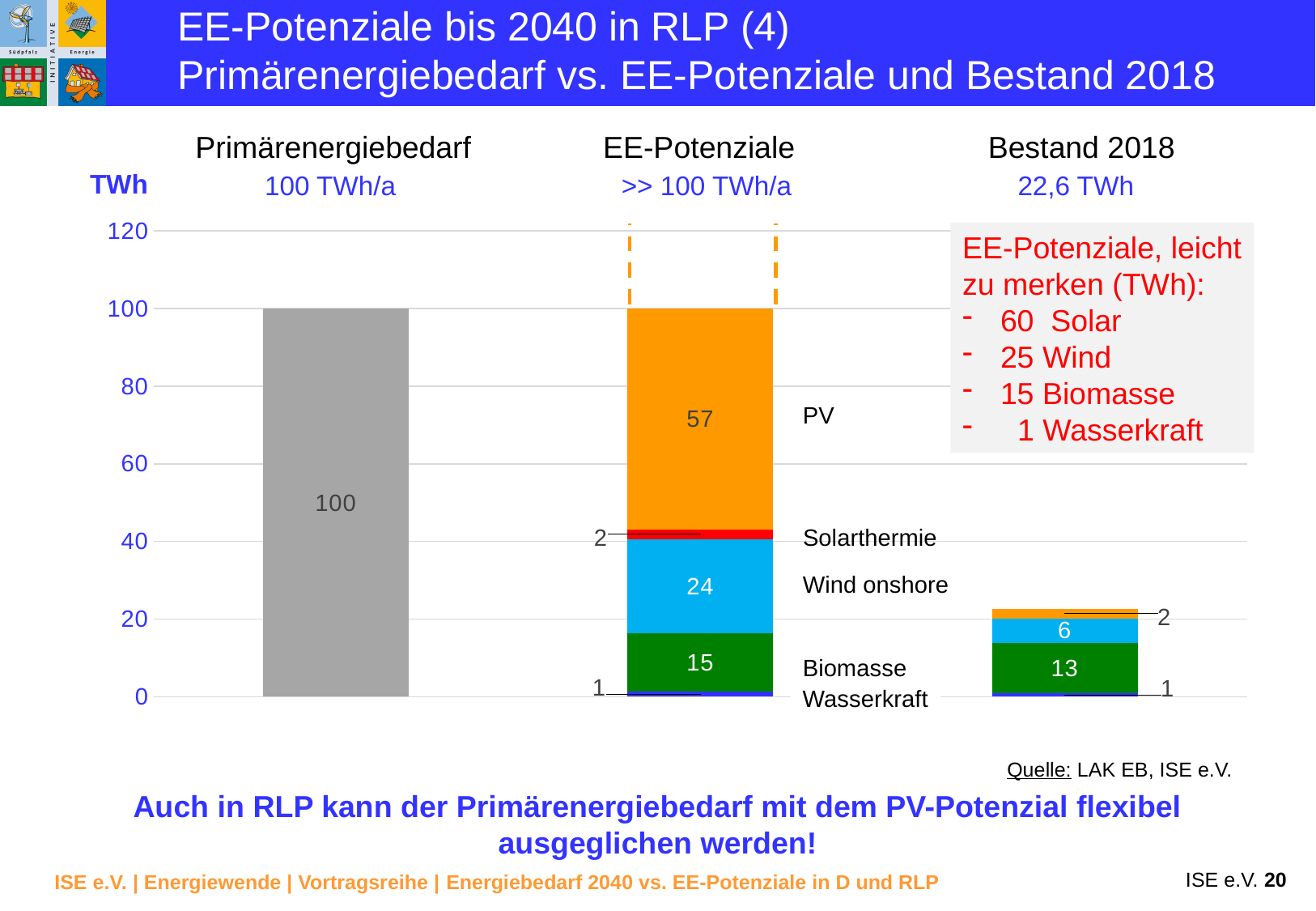
What is the Solarthermie value in the EE-Potenziale bar? 2 What is the value of the Primärenergiebedarf bar? 100 What is the difference between the PV value and the Wind onshore value in the EE-Potenziale bar? 33 What is the PV value in the EE-Potenziale bar? 57 What is the Wind onshore value in the Bestand 2018 bar? 6 What type of chart is shown on the slide? bar chart Which is larger in the EE-Potenziale bar: Biomasse or Wind onshore? Wind onshore What total is given for the Bestand 2018 bar? 22,6 TWh What is the Biomasse value in the Bestand 2018 bar? 13 Which segment of the EE-Potenziale bar is the largest? PV What is the Biomasse value in the EE-Potenziale bar? 15 What is the Wind onshore value in the EE-Potenziale bar? 24